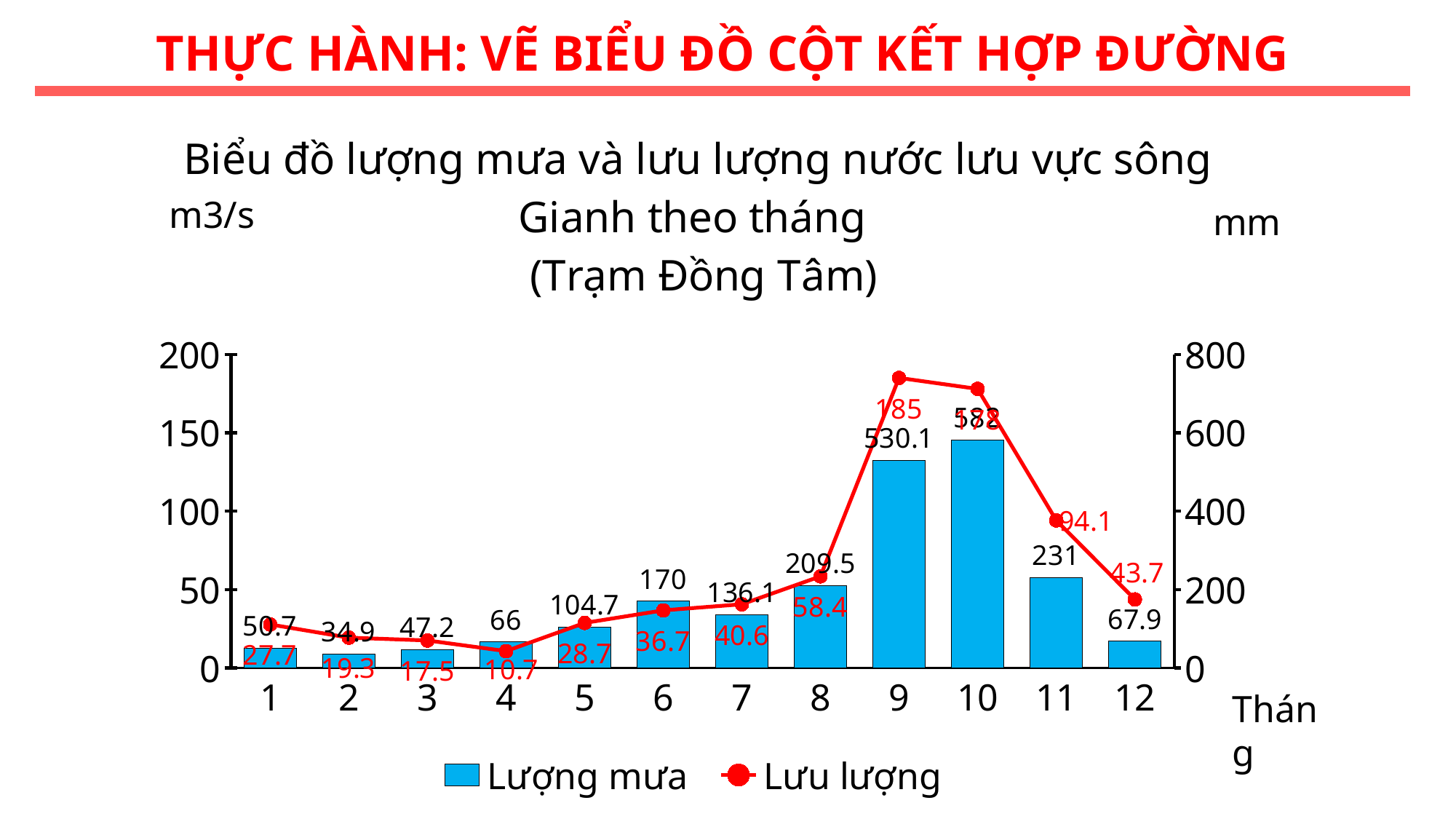
Which month has the highest Lưu lượng? 9 Which month has the highest Lượng mưa? 10 What is the difference between the Lượng mưa values for month 10 and month 9? 51.9 Which month has the lowest Lượng mưa? 2 How many series does the legend list? 2 What is the Lưu lượng value for month 11? 94.1 Which month has the larger Lượng mưa, month 6 or month 7? Month 6 What is the Lưu lượng value for month 4? 10.7 What is the Lượng mưa value for month 9? 530.1 What kind of chart is shown? Combined bar and line chart Which month has the lowest Lưu lượng? 4 How many months are shown on the x axis? 12